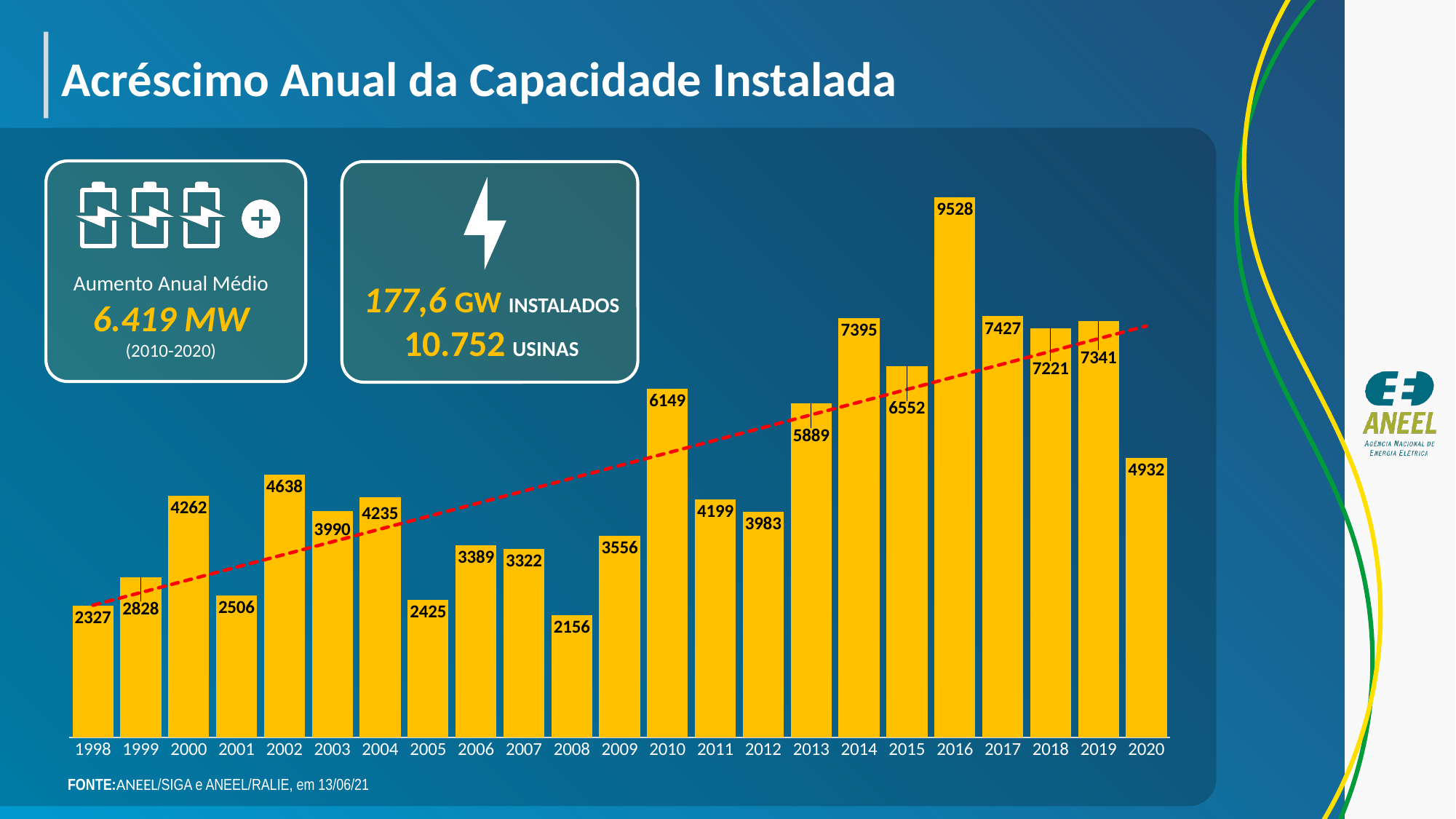
Does the red dashed trend line rise or fall from 1998 to 2020? rise Which is larger, the value for 2014 or the value for 2017? 2017 What kind of chart is shown on the slide? bar chart What is the value for 2016? 9528 Which year has the highest value? 2016 What is the difference between the values for 2010 and 2011? 1950 What is the value for 2020? 4932 How many years are shown on the x axis? 23 What is the difference between the values for 2016 and 2017? 2101 What is the title of the slide? Acréscimo Anual da Capacidade Instalada What is the value for 2008? 2156 Which year has the lowest value? 2008